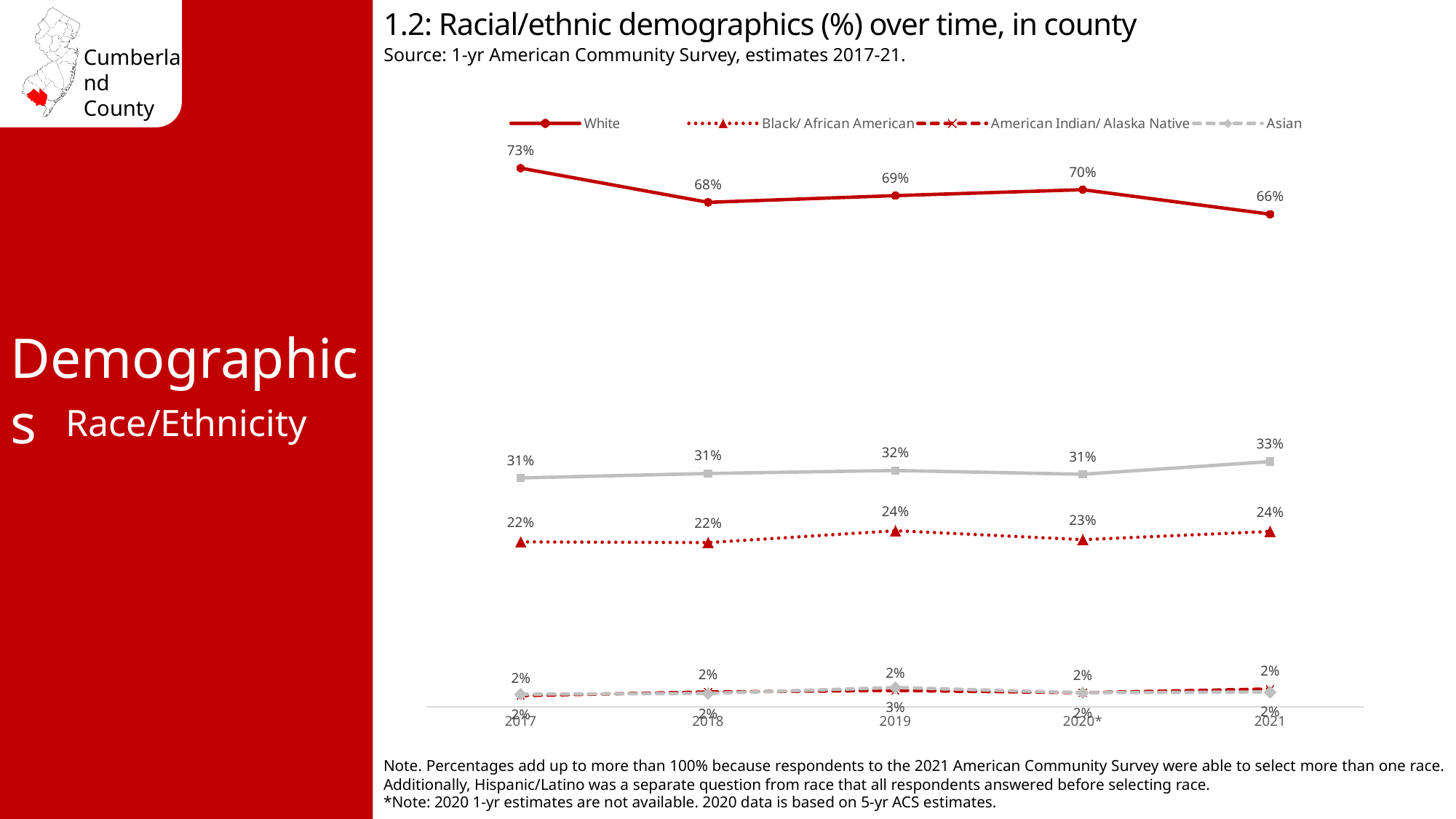
What was the Black/African American percentage in 2020*? 23% What is the title of the chart? 1.2: Racial/ethnic demographics (%) over time, in county What was the White percentage in 2017? 73% What kind of chart is shown on the slide? Line chart What was the White percentage in 2021? 66% What was the Black/African American percentage in 2019? 24% By how many percentage points did the White share fall from 2017 to 2021? 7 percentage points Was the Black/African American percentage higher in 2017 or in 2021? 2021 In which year was the White percentage highest? 2017 How many series does the legend list? 4 In which year was the White percentage lowest? 2021 How many years are plotted on the x axis? 5